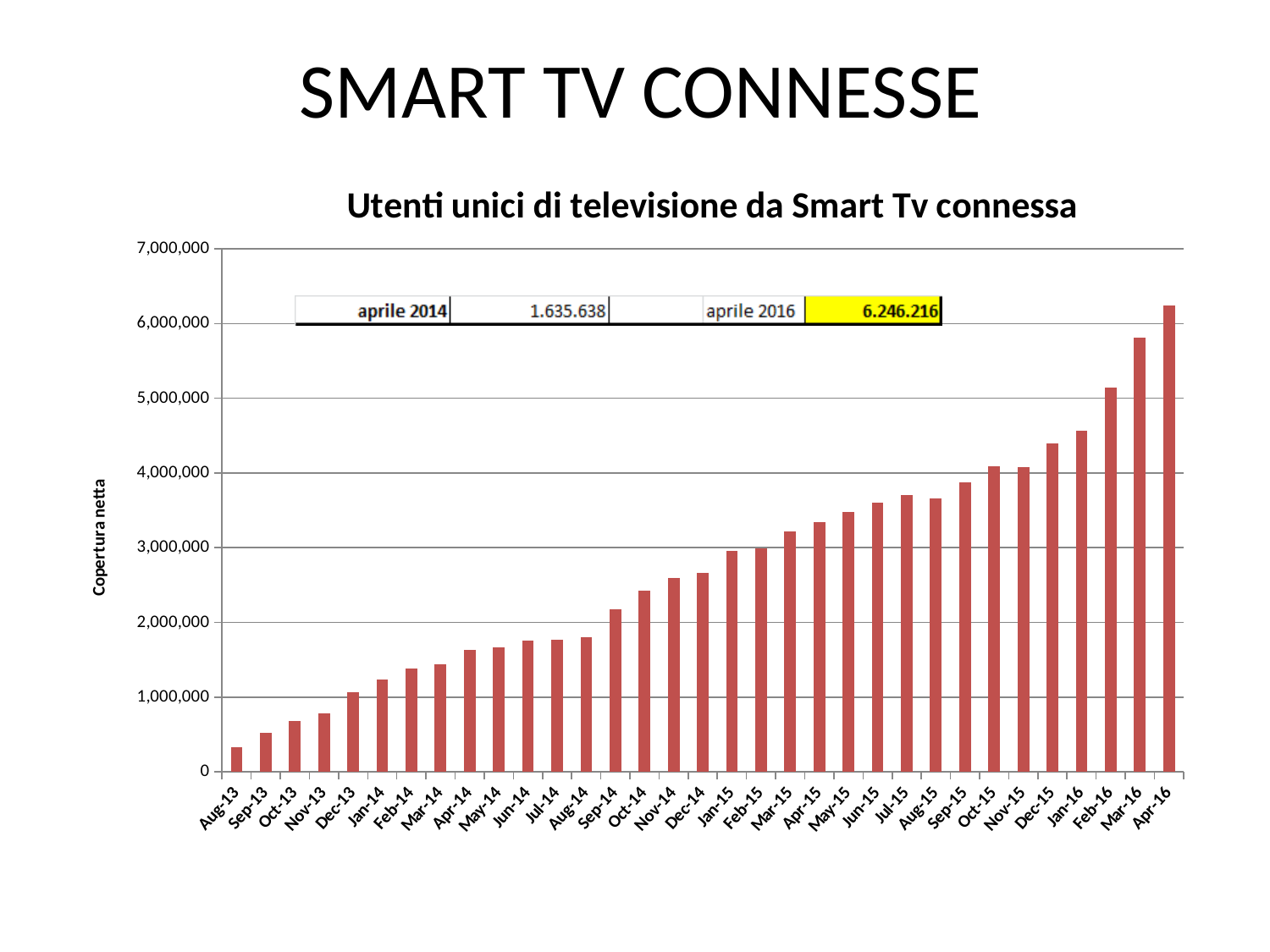
Is the value for Mar-16 greater or less than 5,000,000? greater How many months (bars) are plotted in the chart? 33 What is the label on the vertical axis of the chart? Copertura netta What type of chart is shown on the slide? bar chart Which month has the lowest value in the chart? Aug-13 According to the inset table, what is the value for aprile 2014? 1.635.638 Is the value for Aug-13 greater or less than 1,000,000? less Which month has the highest value in the chart? Apr-16 Do the values generally rise or fall from Aug-13 to Apr-16? rise What is the difference between the aprile 2016 value and the aprile 2014 value shown in the inset table? 4.610.578 According to the inset table, what is the value for aprile 2016? 6.246.216 What is the title of the chart? Utenti unici di televisione da Smart Tv connessa